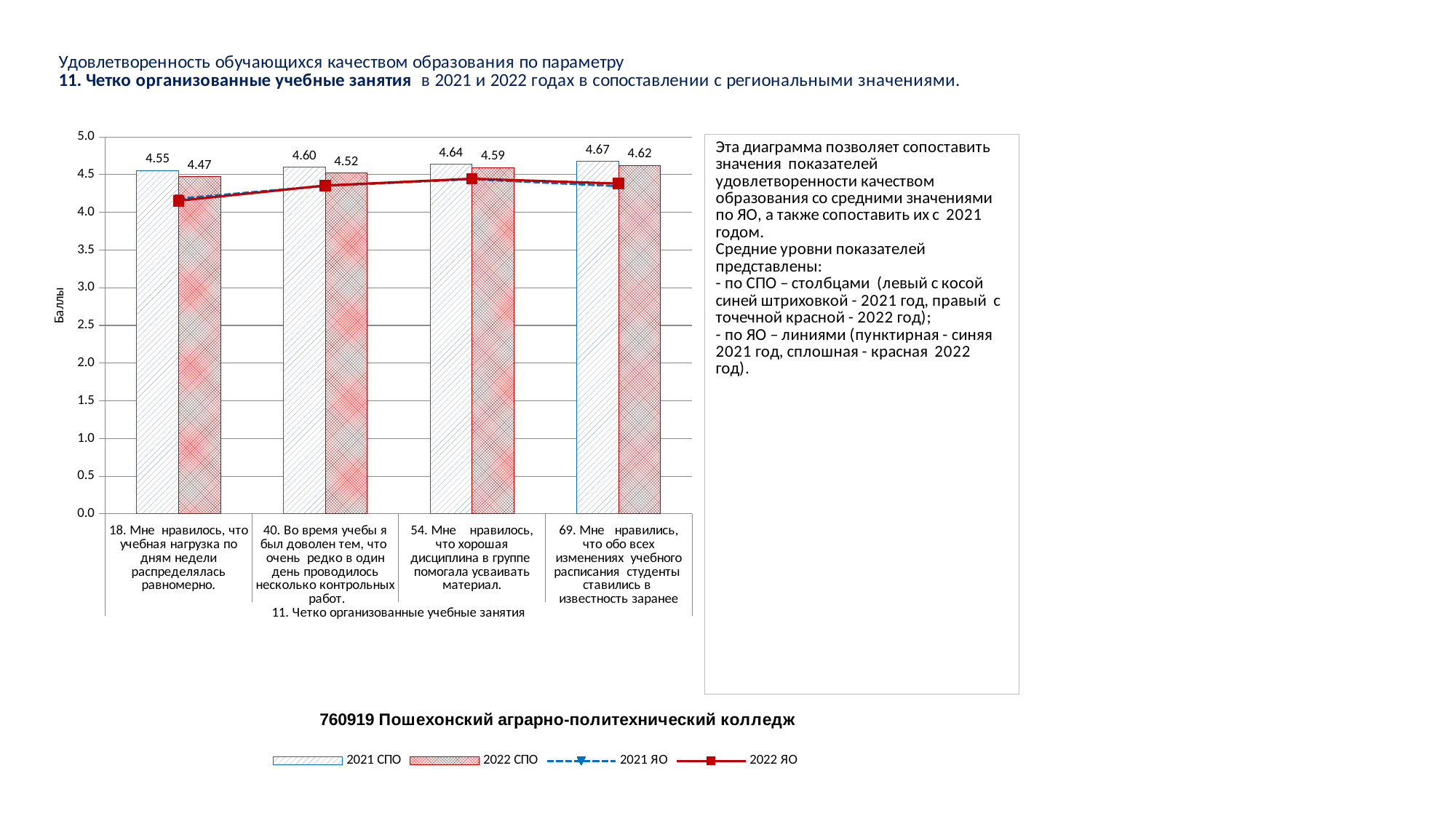
For category 18, which is larger: the 2021 СПО bar or the 2022 СПО bar? 2021 СПО Which category has the highest 2021 СПО bar? 69. Мне нравились, что обо всех изменениях учебного расписания студенты ставились в известность заранее Is the 2022 ЯО line value for category 18 greater or less than 4.5? less What is the value of the 2022 СПО bar for category 69 ("Мне нравились, что обо всех изменениях учебного расписания студенты ставились в известность заранее")? 4.62 What is the value of the 2022 СПО bar for category 40 ("Во время учебы я был доволен тем, что очень редко в один день проводилось несколько контрольных работ")? 4.52 What is the value of the 2021 СПО bar for category 18 ("Мне нравилось, что учебная нагрузка по дням недели распределялась равномерно")? 4.55 What is the difference between the 2021 СПО and 2022 СПО bars for category 54 ("Мне нравилось, что хорошая дисциплина в группе помогала усваивать материал")? 0.05 What kind of chart is shown on the slide? Combined bar and line chart Do the 2022 СПО bar values rise or fall from left to right along the x axis? rise How many categories are shown on the x axis? 4 How many series does the legend list? 4 Which category has the lowest 2022 СПО bar? 18. Мне нравилось, что учебная нагрузка по дням недели распределялась равномерно